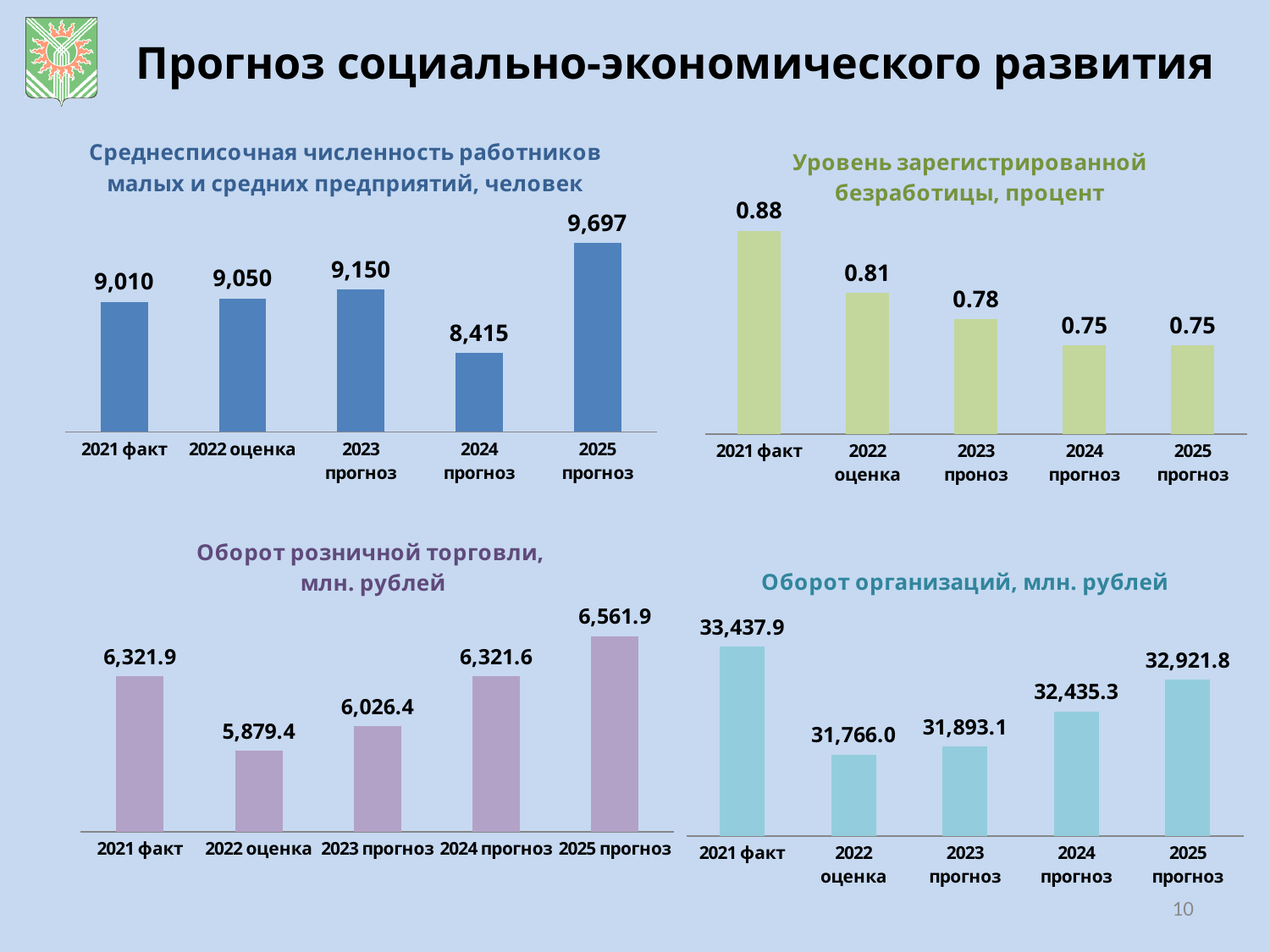
In the bottom-left chart (Оборот розничной торговли, млн. рублей), what is the value for 2023 прогноз? 6,026.4 In the top-left chart (Среднесписочная численность работников малых и средних предприятий, человек), which category has the highest value? 2025 прогноз In the bottom-left chart (Оборот розничной торговли, млн. рублей), what is the difference between the 2025 прогноз and 2022 оценка values? 682.5 What kind of chart is the bottom-right chart (Оборот организаций, млн. рублей)? bar chart In the top-right chart (Уровень зарегистрированной безработицы, процент), what is the value for 2021 факт? 0.88 In the bottom-right chart (Оборот организаций, млн. рублей), which is larger: the value for 2021 факт or the value for 2025 прогноз? 2021 факт In the top-left chart (Среднесписочная численность работников малых и средних предприятий, человек), what is the difference between the 2025 прогноз and 2021 факт values? 687 In the top-right chart (Уровень зарегистрированной безработицы, процент), how many categories are shown on the x axis? 5 In the top-right chart (Уровень зарегистрированной безработицы, процент), do the values rise or fall from 2021 факт to 2024 прогноз? fall In the bottom-right chart (Оборот организаций, млн. рублей), what is the value for 2024 прогноз? 32,435.3 In the bottom-left chart (Оборот розничной торговли, млн. рублей), which category has the lowest value? 2022 оценка In the top-left chart (Среднесписочная численность работников малых и средних предприятий, человек), what is the value for 2024 прогноз? 8,415